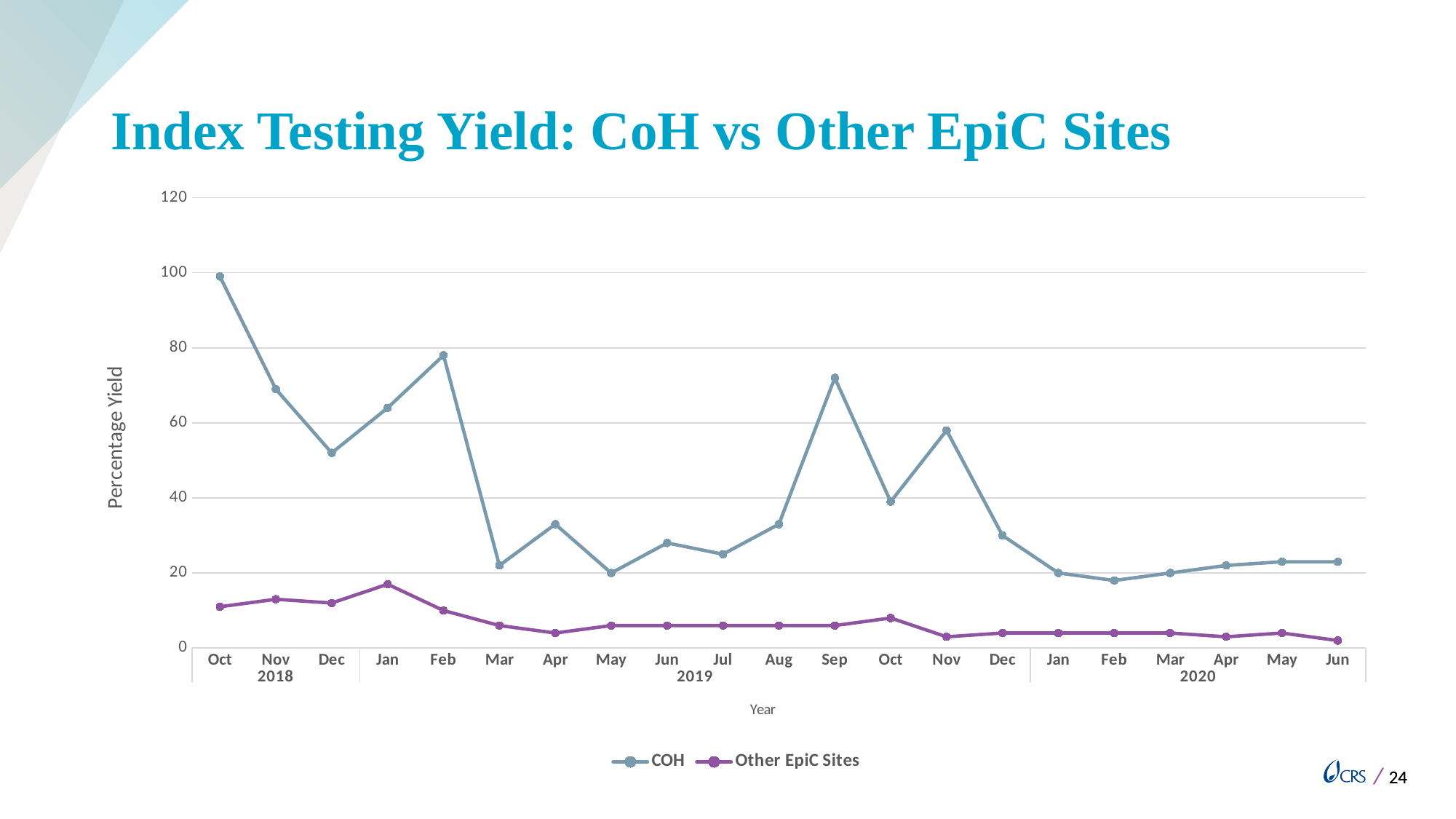
For the COH series, which is larger: the value for Nov 2019 or the value for Dec 2019? Nov 2019 Is the COH value for Oct 2018 greater or less than 80? greater How many series does the legend list? 2 How many monthly data points are plotted for each series? 21 Does the COH series rise or fall from Oct 2018 to Dec 2018? Fall In which month is the Other EpiC Sites series at its highest? Jan 2019 In which month is the COH series at its highest? Oct 2018 Is the Other EpiC Sites value for Jan 2019 greater or less than 20? less Is the COH value for Mar 2019 greater or less than 40? less Which series has the larger value in Oct 2018, COH or Other EpiC Sites? COH What kind of chart is shown on the slide? Line chart